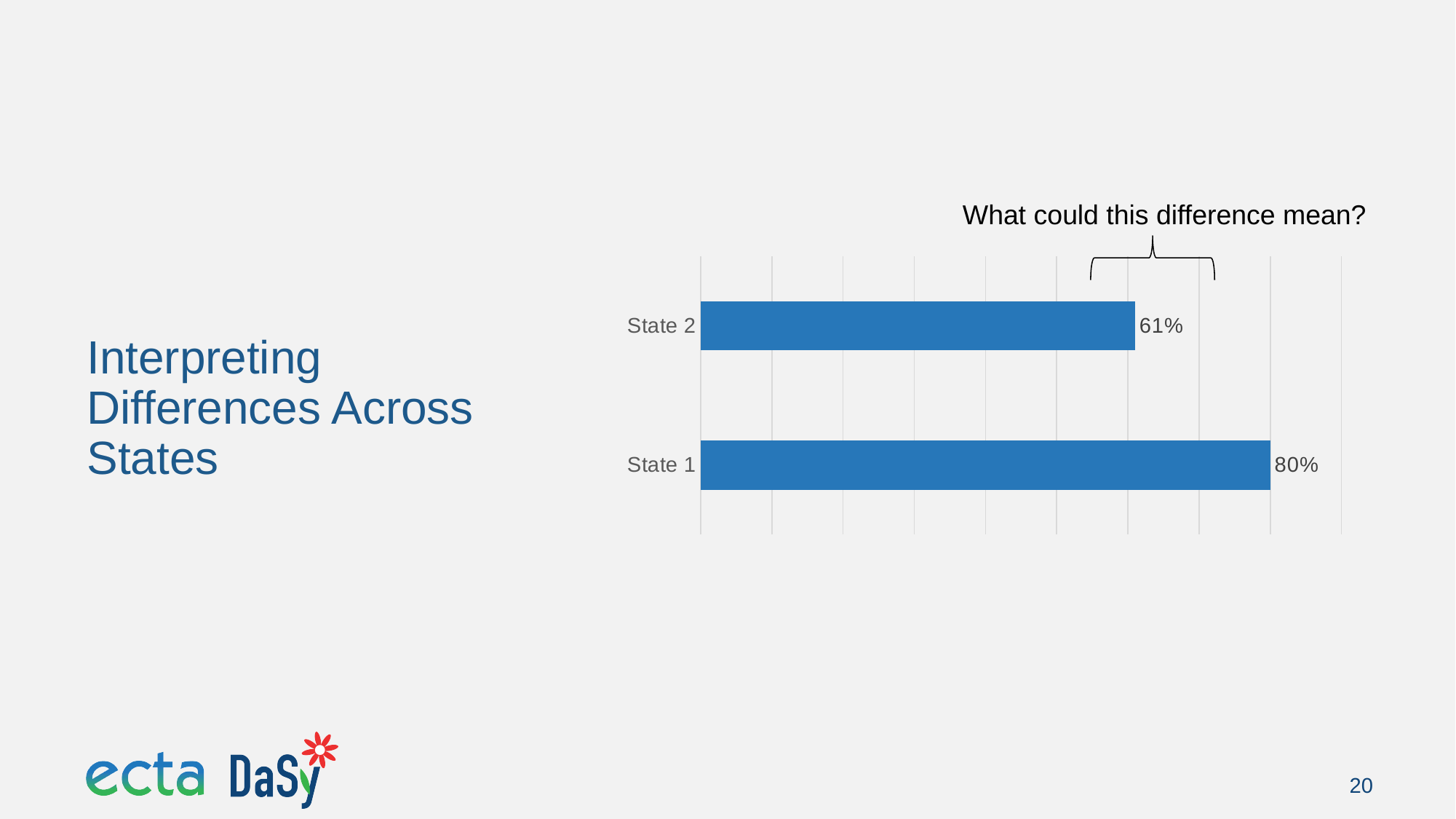
What question is written above the chart? What could this difference mean? What is the difference between the values for State 1 and State 2? 19% What kind of chart is shown on the slide? Bar chart Are the bars in the chart horizontal or vertical? Horizontal Which state has the highest value? State 1 Which state has the lowest value? State 2 What is the value for State 1? 80% What is the value for State 2? 61% How many states are shown in the chart? 2 Which is larger, the value for State 1 or the value for State 2? State 1